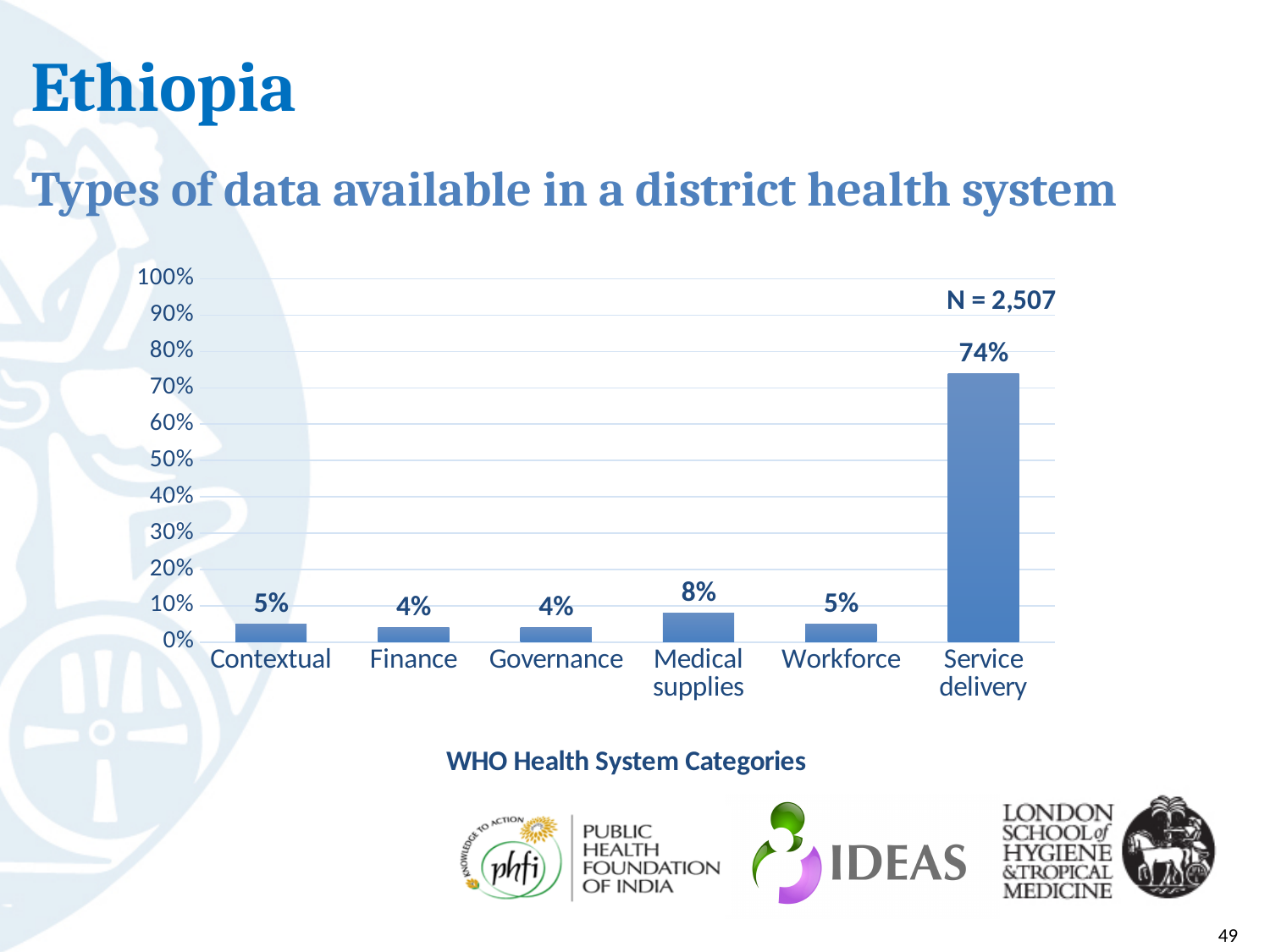
What is the sample size (N) shown on the chart? N = 2,507 What is the difference between the Service delivery and Medical supplies values? 66% What percentage of data is in the Service delivery category? 74% Which category has the highest value? Service delivery Which is larger, the value for Medical supplies or the value for Workforce? Medical supplies What is the value for Contextual? 5% What is the value for Medical supplies? 8% How many categories are shown on the x axis? 6 Is the value for Service delivery greater or less than 70%? greater What is the value for Finance? 4% What kind of chart is shown on the slide? Bar chart What is the x-axis title of the chart? WHO Health System Categories